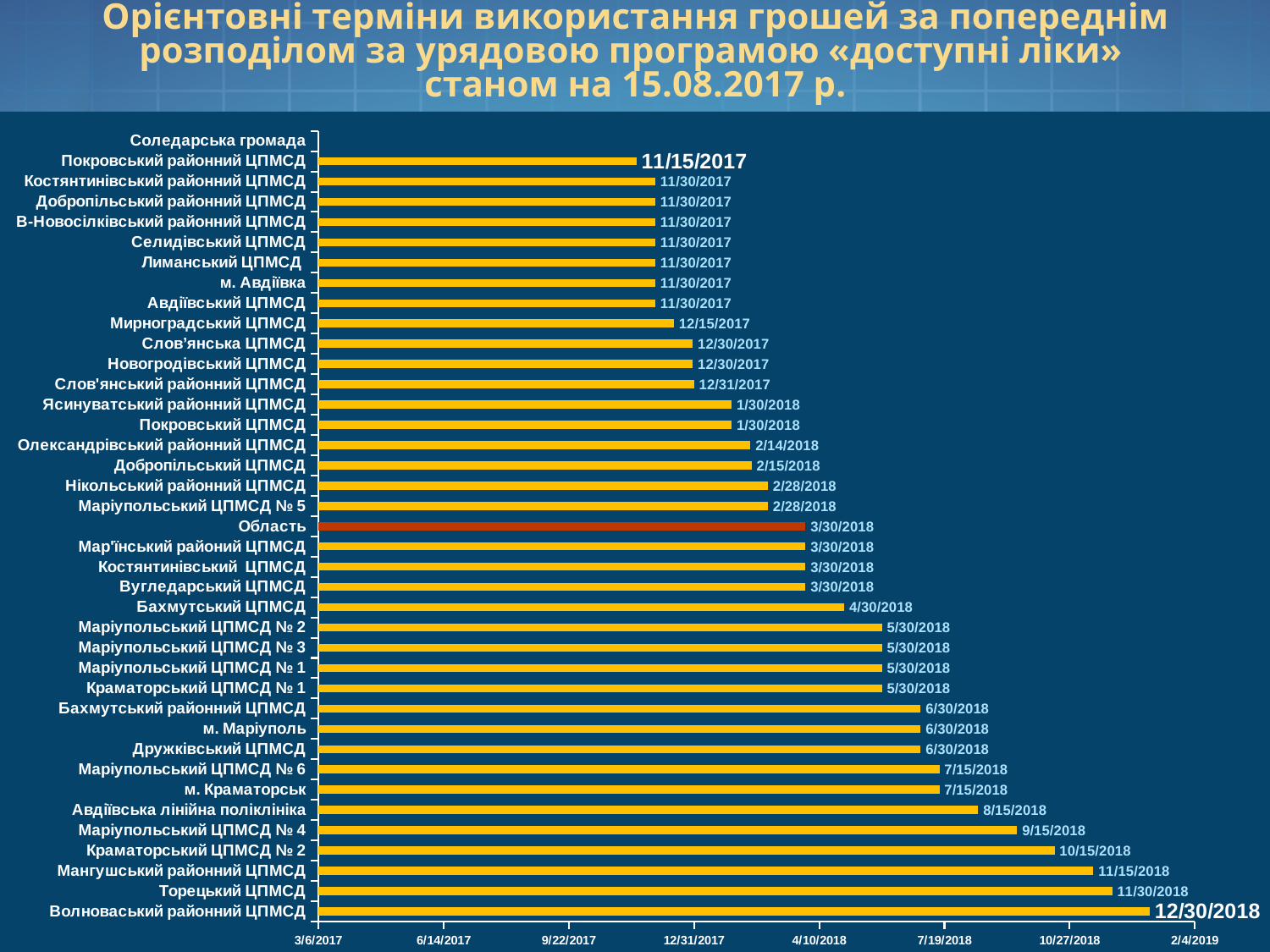
What date is shown for Область? 3/30/2018 Which has a later date, Мирноградський ЦПМСД or Краматорський ЦПМСД № 2? Краматорський ЦПМСД № 2 What date is shown for Мангушський районний ЦПМСД? 11/15/2018 What date is shown for Бахмутський ЦПМСД? 4/30/2018 Which category with a bar has the earliest date (shortest bar)? Покровський районний ЦПМСД What date is shown for Волноваський районний ЦПМСД? 12/30/2018 Which has a later date, Торецький ЦПМСД or Дружківський ЦПМСД? Торецький ЦПМСД What date is shown for Покровський районний ЦПМСД? 11/15/2017 Which category's bar is shown in a different colour (red) from the others? Область What kind of chart is shown on the slide? Bar chart What date is shown for Авдіївська лінійна поліклініка? 8/15/2018 Which category has the latest date (longest bar)? Волноваський районний ЦПМСД